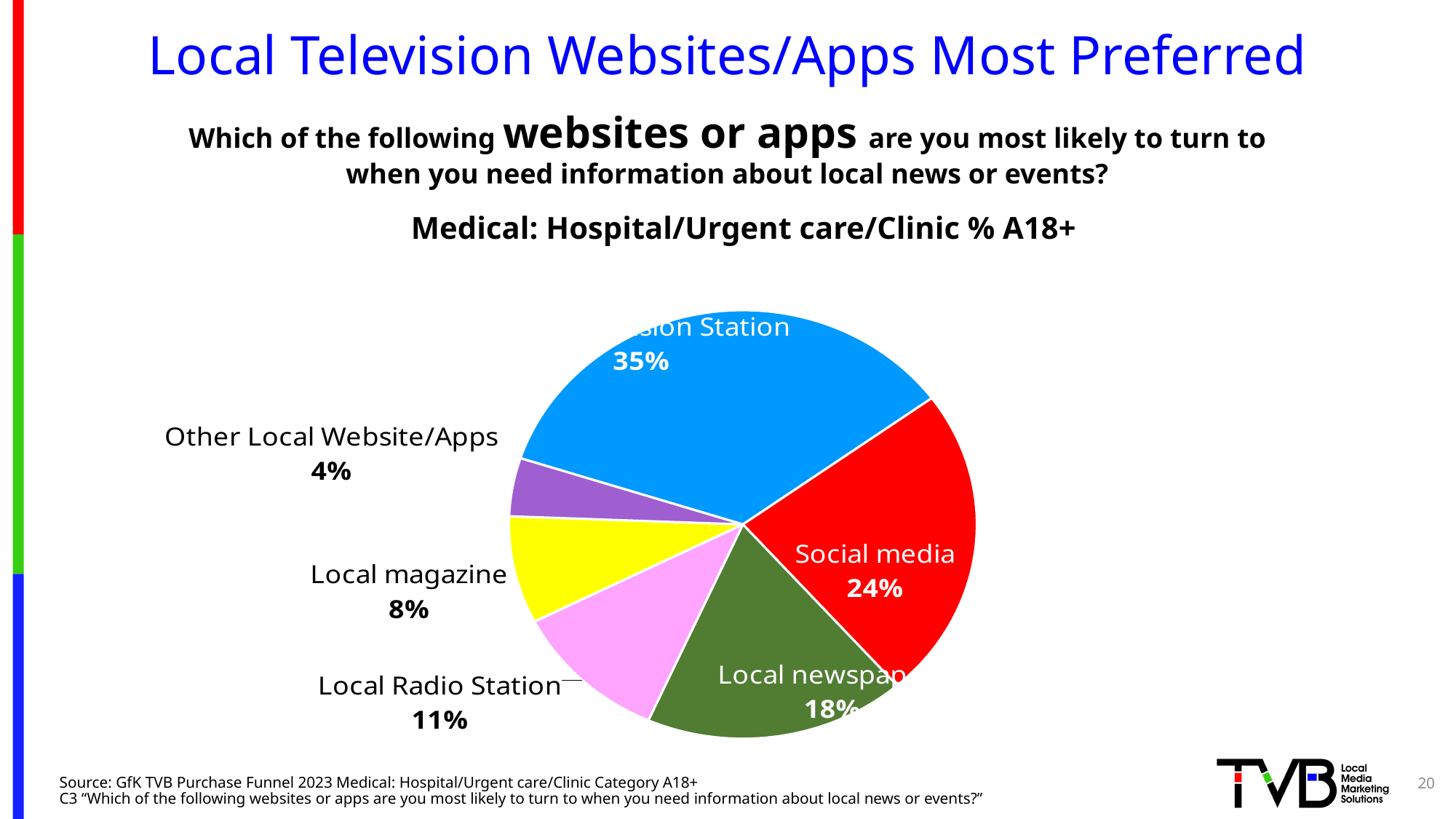
Which category has the smallest slice of the pie? Other Local Website/Apps What percentage is shown for Local magazine? 8% What percentage is shown on the largest (blue) slice of the pie? 35% Which is larger, Local Radio Station or Local magazine? Local Radio Station What percentage is shown for Social media? 24% How many slices does the pie chart have? 6 What kind of chart is shown on the slide? pie chart What share of the pie does Local newspaper represent? 18% What is the difference in percentage points between Social media and Local newspaper? 6 What percentage is shown for Other Local Website/Apps? 4% What percentage is shown for Local Radio Station? 11% What colour is the Social media slice? red